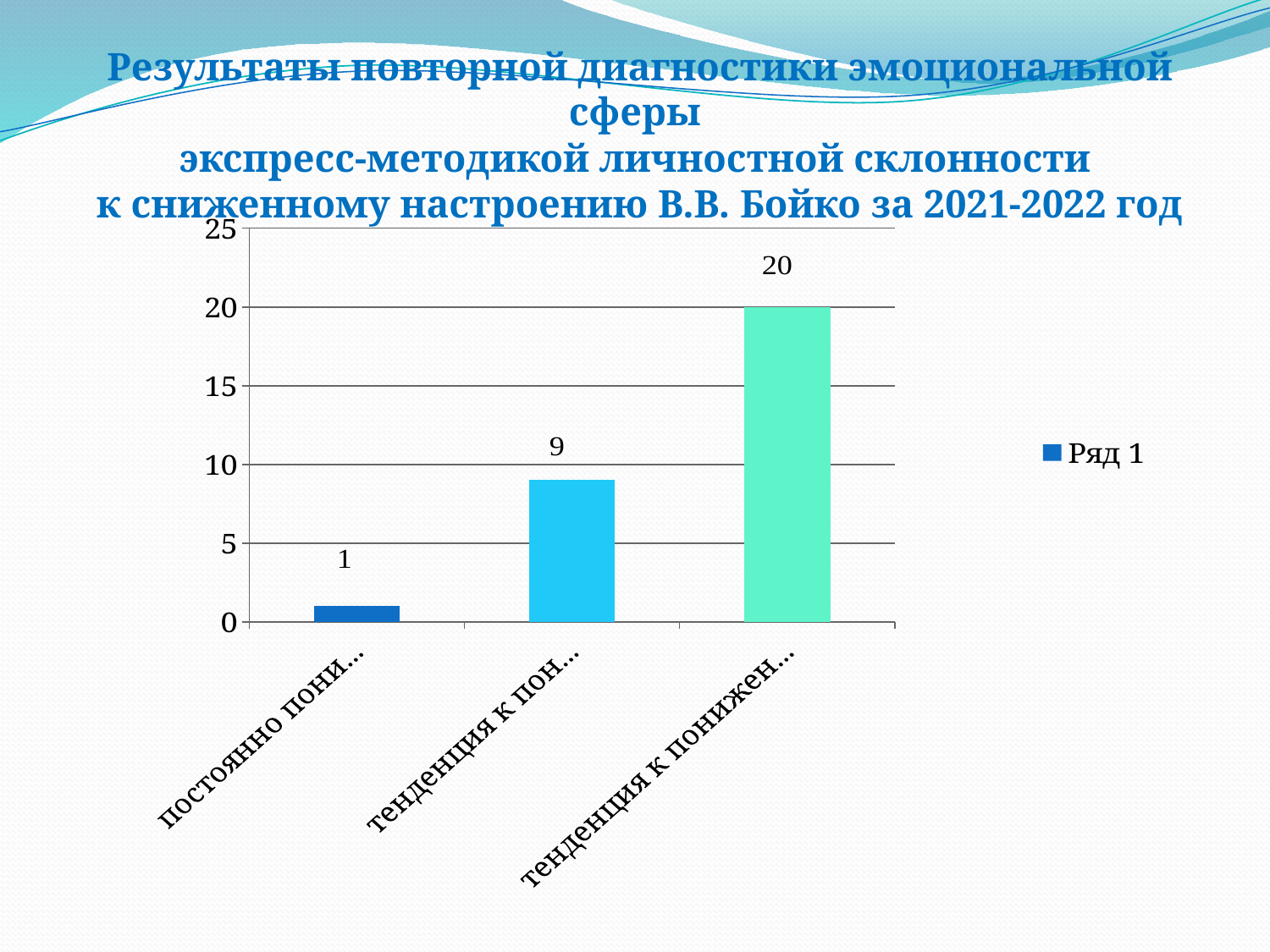
What is the value of the leftmost bar (labelled "постоянно пони...")? 1 What is the value of the middle bar (labelled "тенденция к пон...")? 9 What is the name of the series shown in the legend? Ряд 1 Which is larger, the middle bar or the leftmost bar? the middle bar How many bars (categories) does the chart show? 3 How many series does the legend list? 1 Which bar has the highest value? the rightmost bar (тенденция к понижен...) Which bar has the lowest value? the leftmost bar (постоянно пони...) Do the bar values rise or fall from left to right along the x axis? rise What is the difference between the rightmost bar and the middle bar? 11 What is the value of the rightmost bar (labelled "тенденция к понижен...")? 20 What type of chart is shown on the slide? bar chart